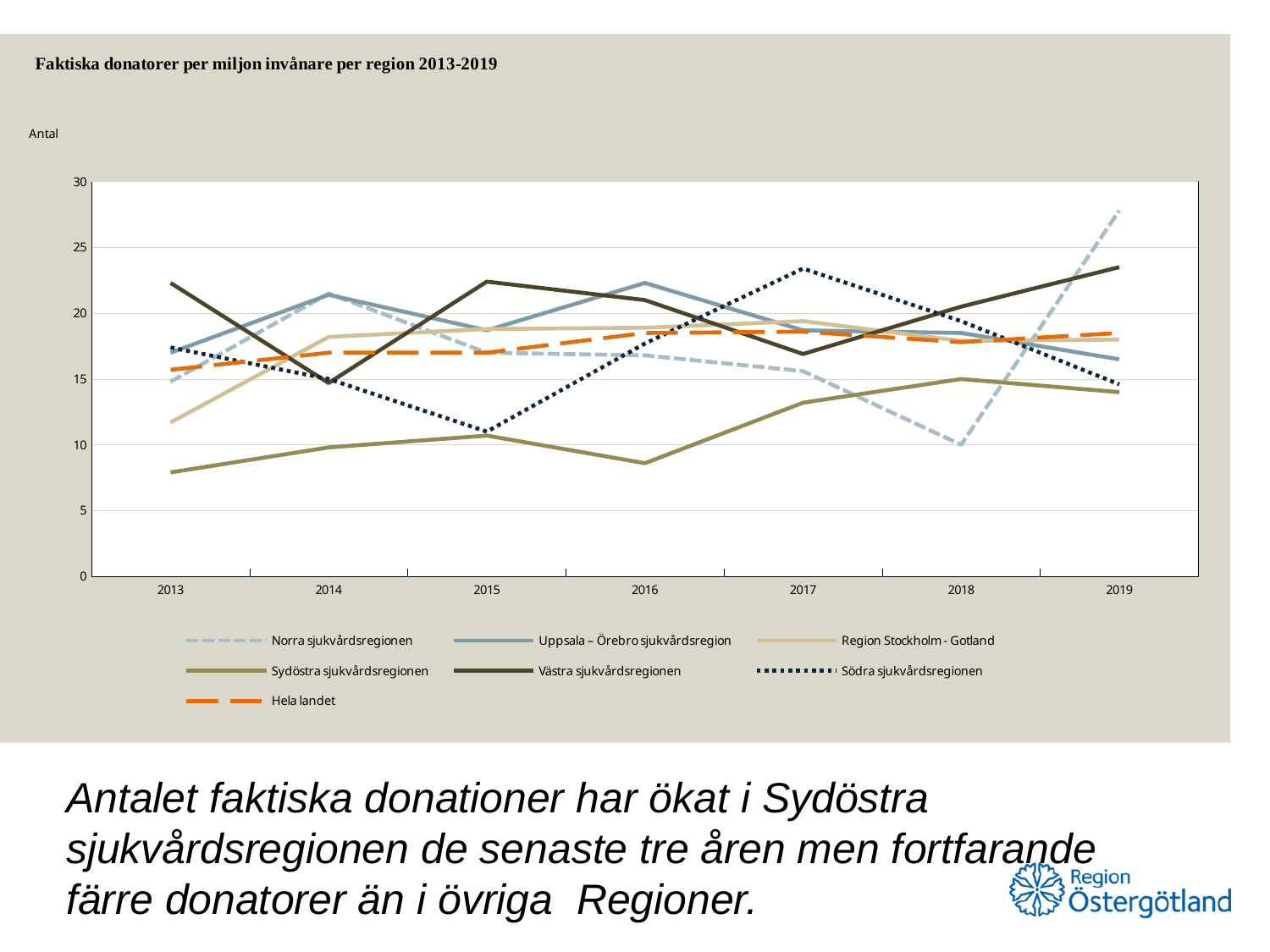
How many years are shown along the x axis? 7 Is the value for Sydöstra sjukvårdsregionen in 2013 greater or less than 10? less In 2017, which is larger: Södra sjukvårdsregionen or Sydöstra sjukvårdsregionen? Södra sjukvårdsregionen Is the value for Norra sjukvårdsregionen in 2019 greater or less than 25? greater Which region has the highest value in 2019? Norra sjukvårdsregionen Is the value for Norra sjukvårdsregionen in 2018 greater or less than 15? less Which region has the lowest value in 2016? Sydöstra sjukvårdsregionen How many series does the legend list? 7 Does the value for Sydöstra sjukvårdsregionen rise or fall from 2016 to 2018? rise What kind of chart is shown on the slide? Line chart What is the title of the chart? Faktiska donatorer per miljon invånare per region 2013-2019 Which region has the lowest value in 2013? Sydöstra sjukvårdsregionen